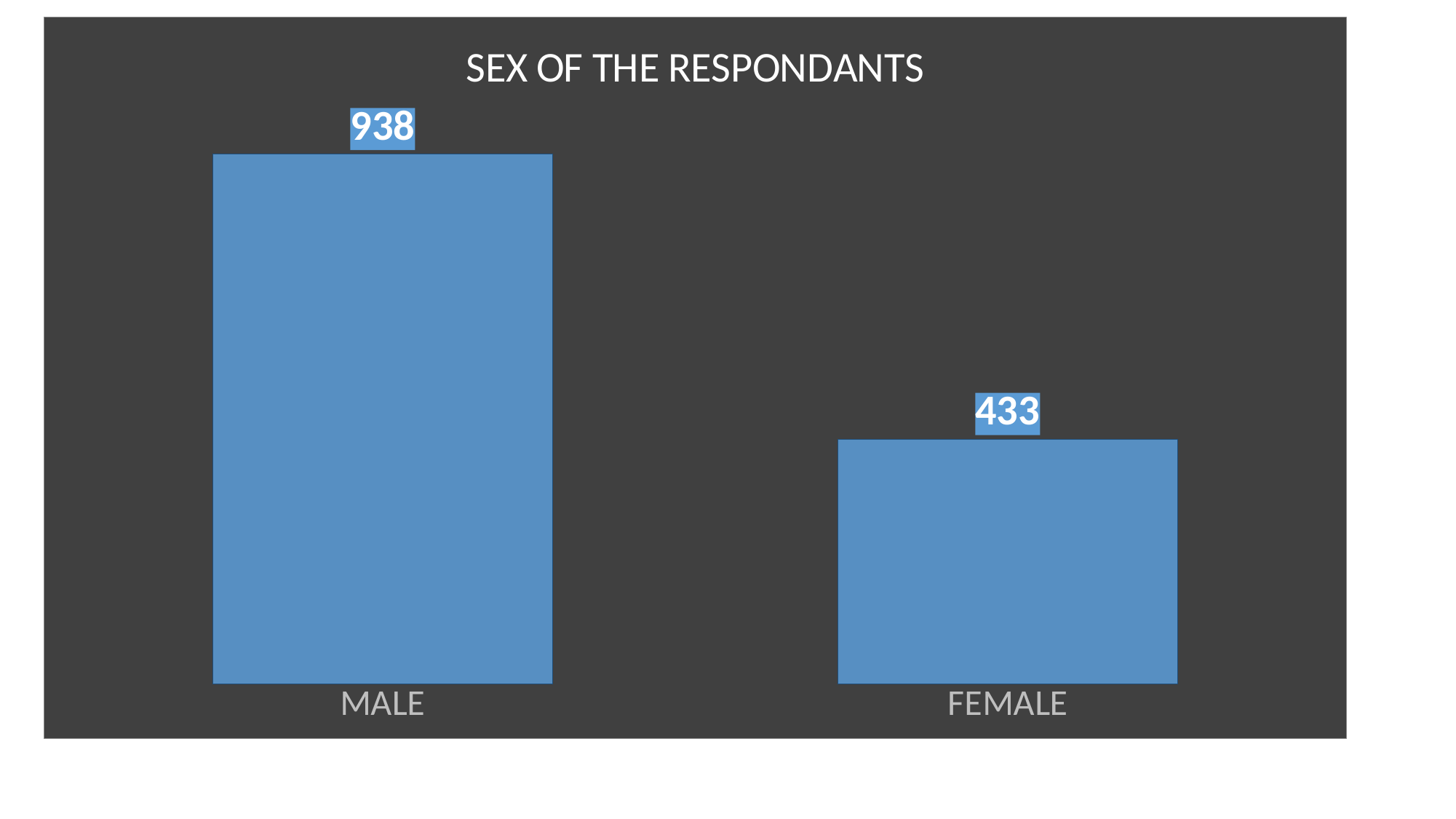
What is the title of the chart? SEX OF THE RESPONDANTS How many categories are shown in the chart? 2 What kind of chart is shown on the slide? bar chart What colour are the bars in the chart? blue Which is larger, the value for MALE or the value for FEMALE? MALE What is the difference between the values for MALE and FEMALE? 505 Which category has the lowest value? FEMALE What is the value for MALE? 938 What is the total of the values for MALE and FEMALE? 1371 Which category has the highest value? MALE What is the value for FEMALE? 433